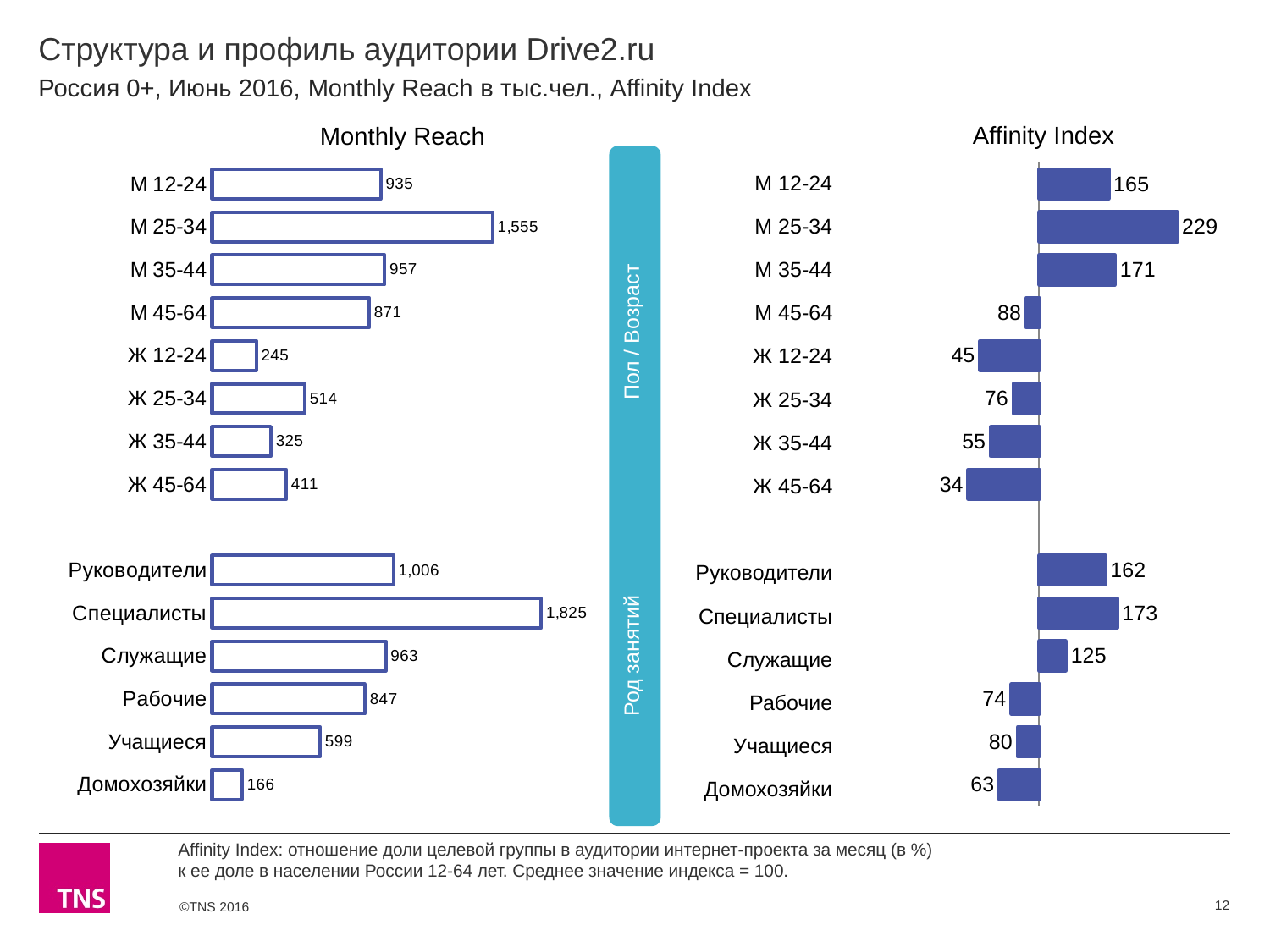
In the Affinity Index chart, which category has the highest value? М 25-34 In the Affinity Index chart, what is the difference between the values for Специалисты and Руководители? 11 In the Affinity Index chart, which is larger: the value for Учащиеся or the value for Рабочие? Учащиеся In the Monthly Reach chart, what is the value for М 25-34? 1,555 How many categories are plotted in the Monthly Reach chart? 14 What kind of chart is the Affinity Index chart? Bar chart In the Monthly Reach chart, what is the difference between the values for М 35-44 and М 45-64? 86 In the Monthly Reach chart, which category has the highest value? Специалисты In the Monthly Reach chart, which is larger: the value for Служащие or the value for Рабочие? Служащие In the Affinity Index chart, what is the value for Ж 45-64? 34 In the Monthly Reach chart, which category has the lowest value? Домохозяйки In the Affinity Index chart, which category has the lowest value? Ж 45-64